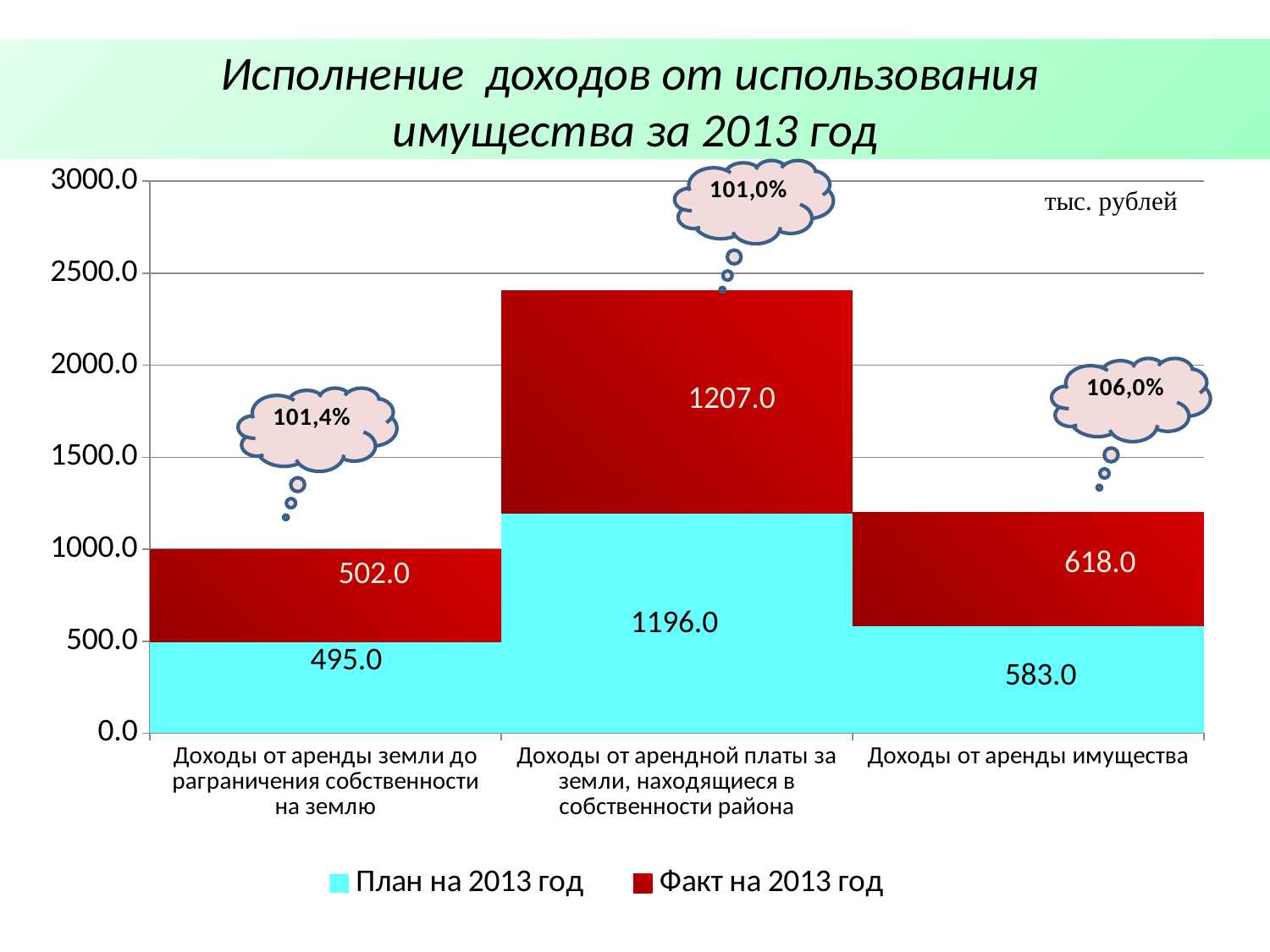
What is the value of 'План на 2013 год' for 'Доходы от аренды имущества'? 583.0 Which category has the highest value for 'Факт на 2013 год'? Доходы от арендной платы за земли, находящиеся в собственности района What is the total of the stacked bar for 'Доходы от арендной платы за земли, находящиеся в собственности района'? 2403.0 How many categories are shown on the x axis? 3 What kind of chart is shown on the slide? Stacked bar chart How many series does the legend list? 2 What is the value of 'Факт на 2013 год' for 'Доходы от арендной платы за земли, находящиеся в собственности района'? 1207.0 What is the value of 'План на 2013 год' for 'Доходы от аренды земли до разграничения собственности на землю'? 495.0 Which is larger for 'Доходы от аренды земли до разграничения собственности на землю': 'План на 2013 год' or 'Факт на 2013 год'? Факт на 2013 год Which category has the lowest value for 'План на 2013 год'? Доходы от аренды земли до разграничения собственности на землю What percentage is shown in the cloud callout above 'Доходы от аренды имущества'? 106,0% What is the difference between 'Факт на 2013 год' and 'План на 2013 год' for 'Доходы от аренды имущества'? 35.0